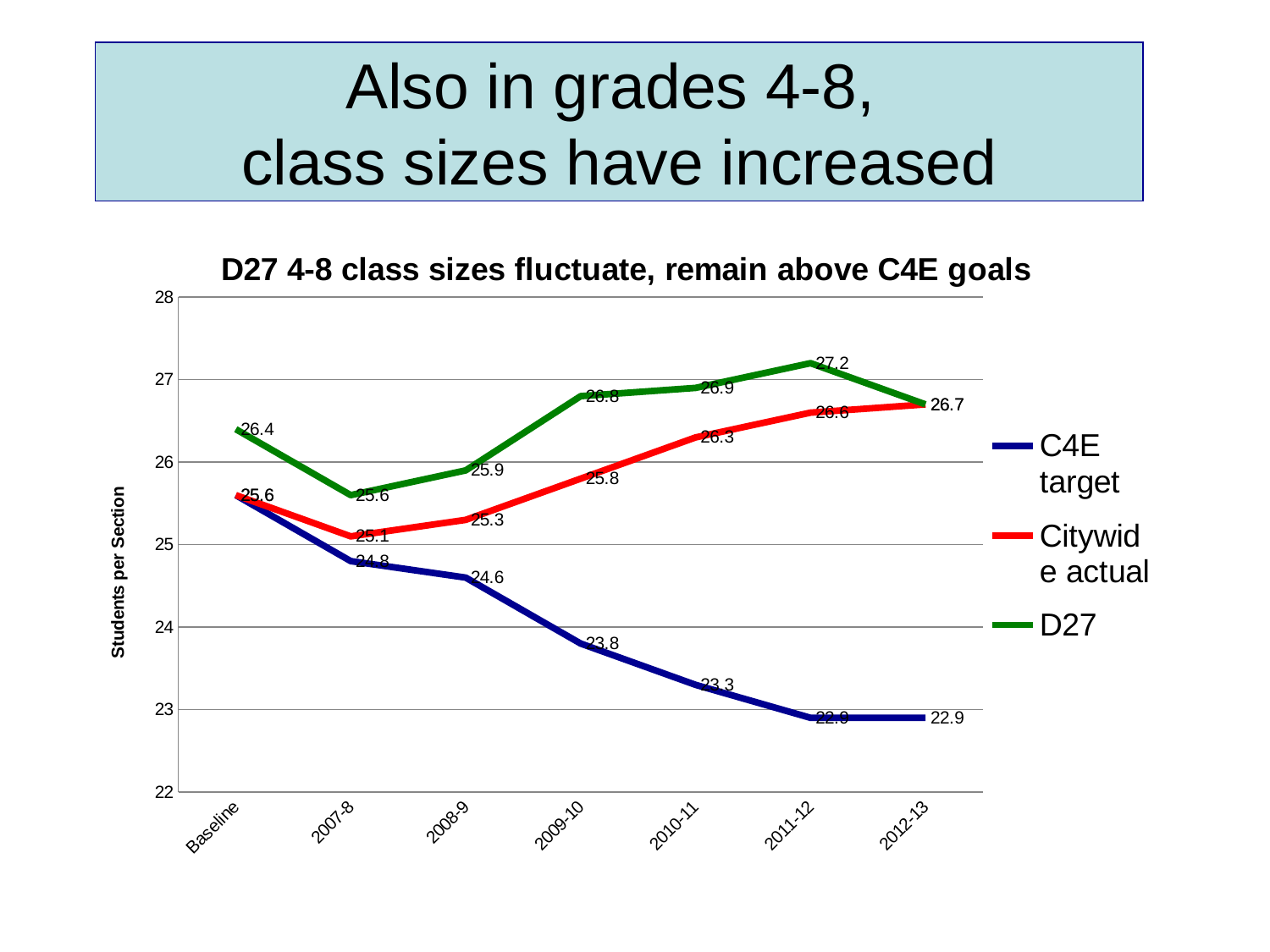
What type of chart is shown on the slide? line chart What is the title of the chart? D27 4-8 class sizes fluctuate, remain above C4E goals How many points are plotted along the x axis for each series? 7 What is the Citywide actual value for 2010-11? 26.3 Which is larger at Baseline: the D27 value or the Citywide actual value? D27 How many series does the legend list? 3 What is the C4E target value for 2009-10? 23.8 Does the C4E target series rise or fall from Baseline to 2012-13? fall In which year is the Citywide actual value lowest? 2007-8 In which year does the D27 series reach its highest value? 2011-12 What is the D27 value for 2011-12? 27.2 What is the difference between the D27 value and the C4E target value in 2012-13? 3.8